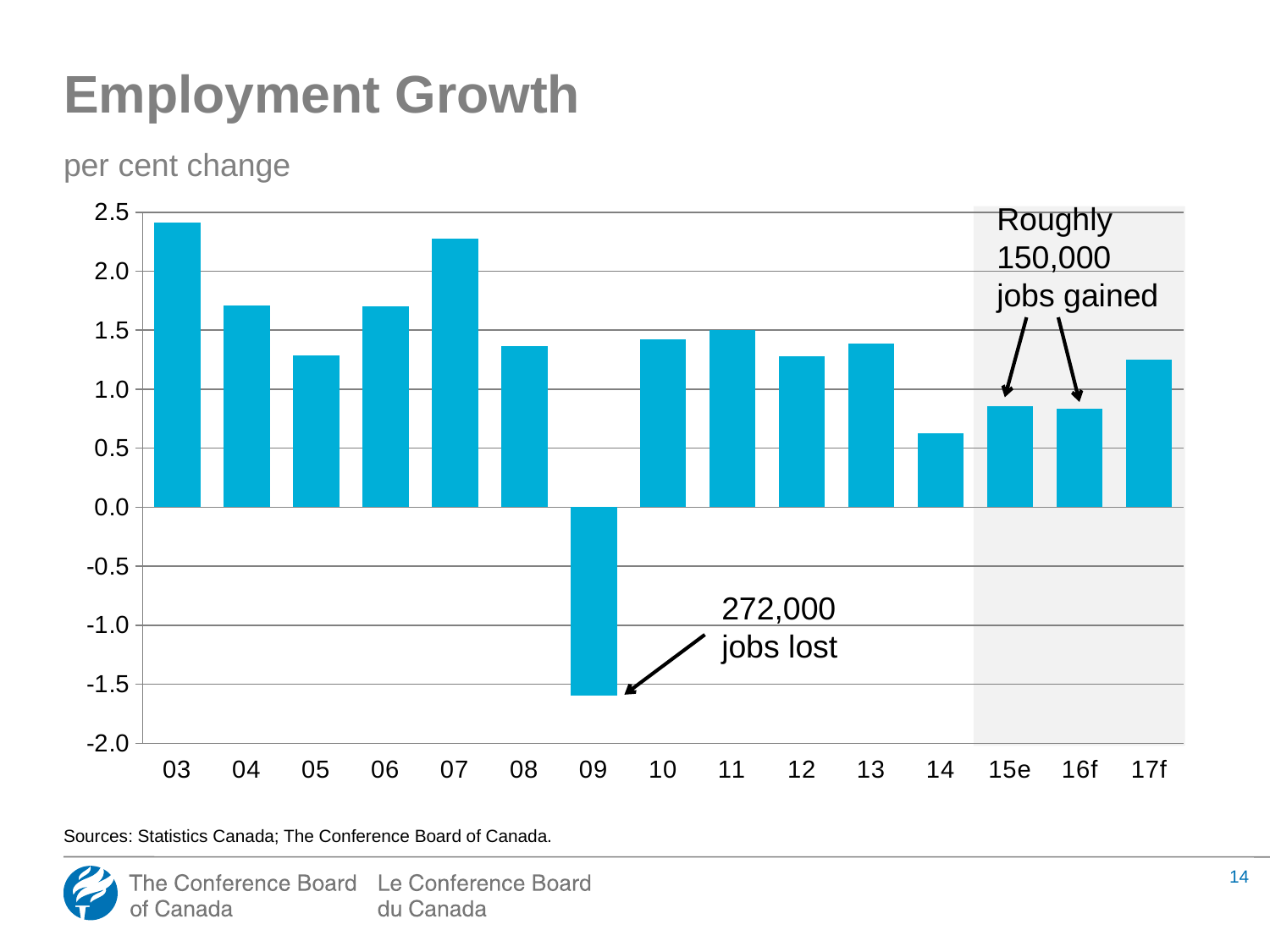
Is the value for 03 greater or less than 2.0? greater Is the value for 09 greater or less than -1.5? less What kind of chart is shown on the slide? bar chart Is the value for 14 greater or less than 0.5? greater According to the annotation, how many jobs were lost in 09? 272,000 How many years are shown along the x axis of the chart? 15 Which year has the lowest employment growth? 09 Which year has the highest employment growth? 03 Do the values rise or fall from 07 to 09? fall What is the title of the chart? Employment Growth Which is larger, the value for 04 or the value for 05? 04